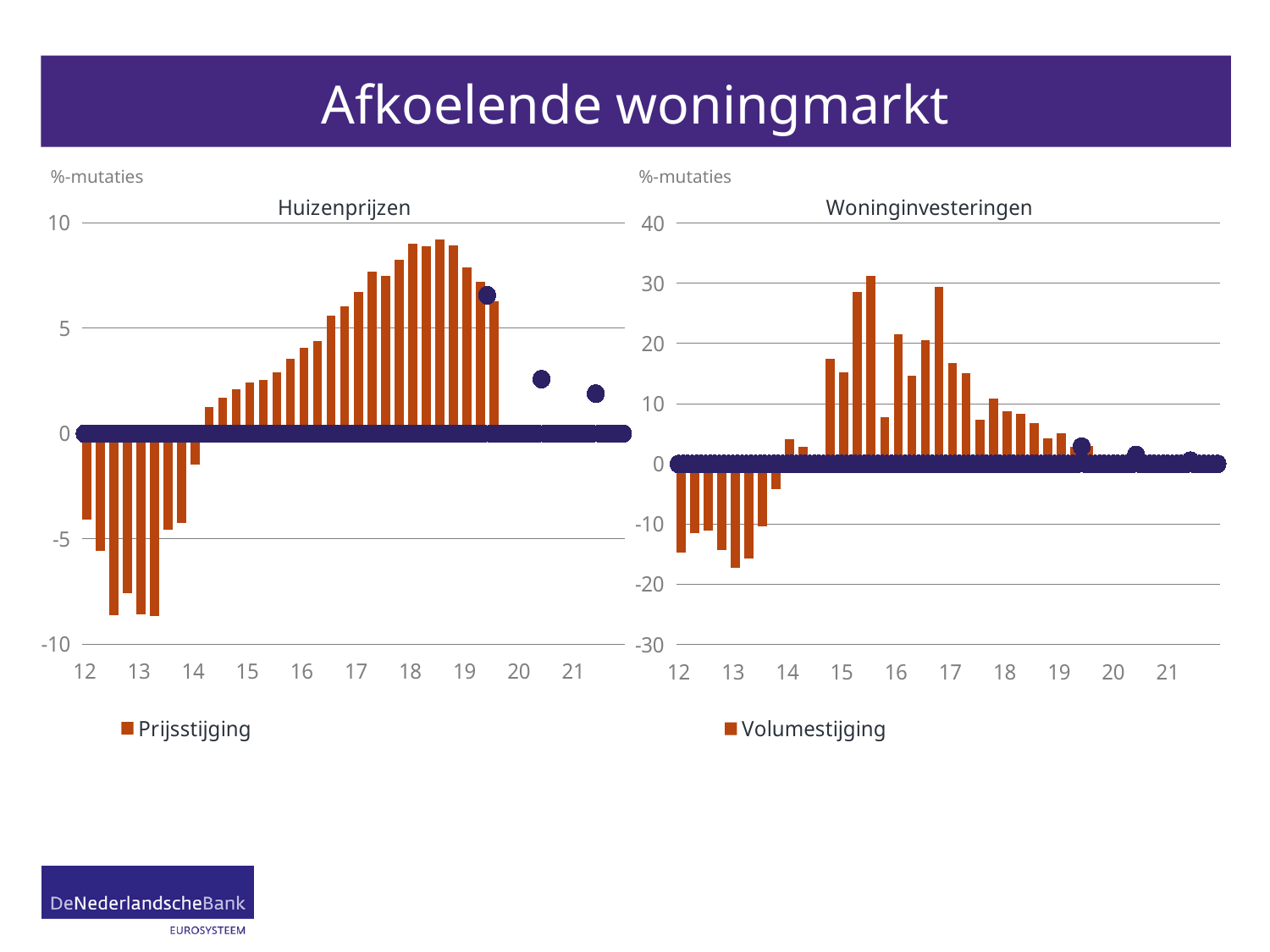
In the Huizenprijzen chart, is the highest bar greater or less than 5? greater In the Woninginvesteringen chart, what is the legend entry for the bars? Volumestijging What kind of chart is the Huizenprijzen chart? bar chart In the Huizenprijzen chart, do the bars rise or fall from 2013 to 2018? rise In the Huizenprijzen chart, what is the legend entry for the bars? Prijsstijging In the Huizenprijzen chart, which year has larger bars, 2013 or 2018? 2018 In the Woninginvesteringen chart, is the lowest bar (in 2013) greater or less than -10? less In the Huizenprijzen chart, is the lowest bar (in 2013) greater or less than -5? less What kind of chart is the Woninginvesteringen chart? bar chart How many charts are shown on the slide? 2 In the Woninginvesteringen chart, do the bars rise or fall from 2017 to 2019? fall